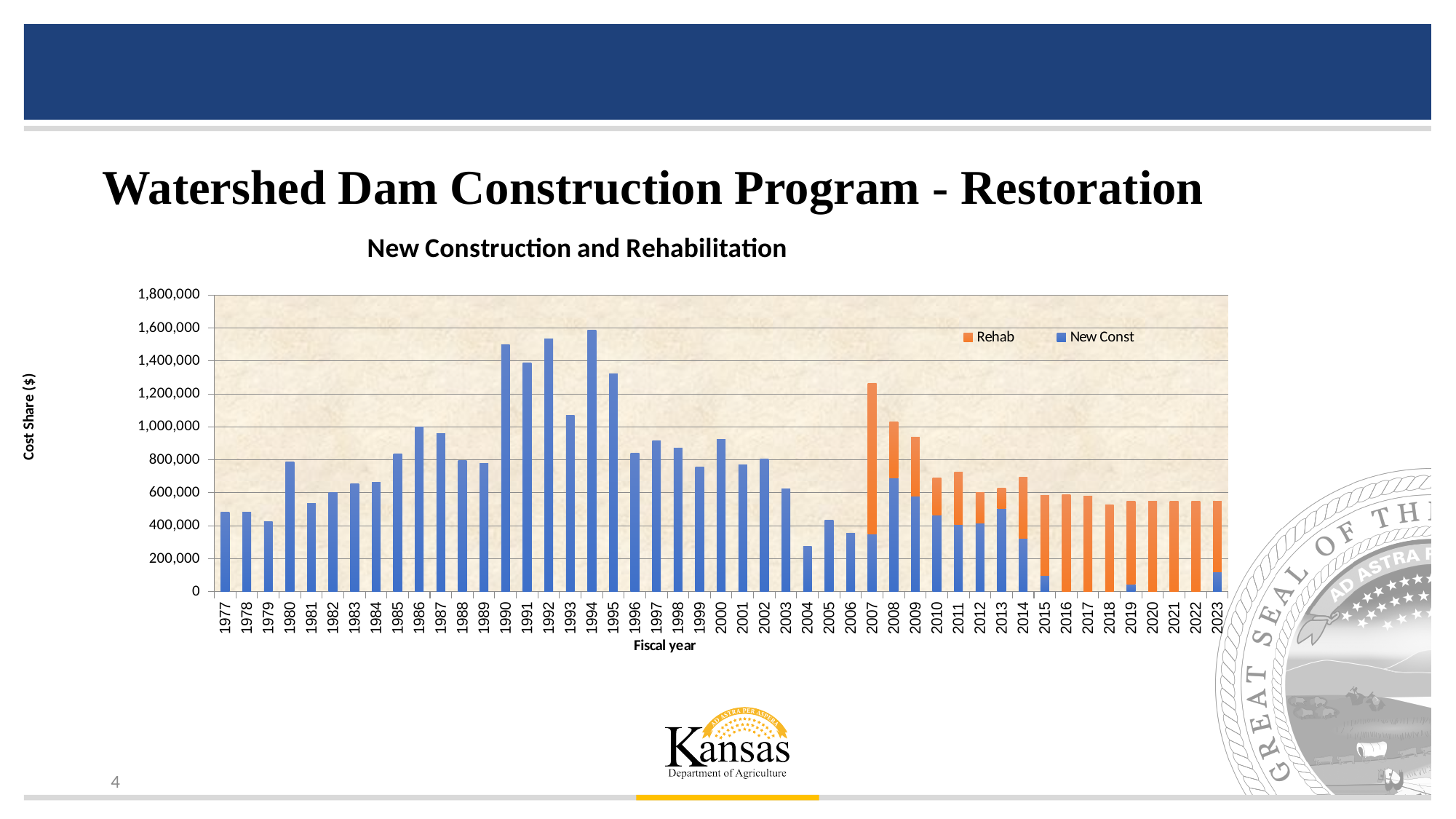
Is the total bar for 1994 greater or less than 1,400,000? greater Which colour represents the Rehab series in the chart? Orange Is the total bar for 2007 greater or less than 1,200,000? greater Which fiscal year has the shortest bar in the chart? 2004 How many fiscal years are shown on the x axis of the chart? 47 How many series does the legend list in the chart? 2 Which fiscal year has the larger bar, 1990 or 1980? 1990 Which fiscal year has the tallest bar in the chart? 1994 Do the bar totals generally rise or fall from 1994 to 2004? fall Is the bar for 2016 greater or less than 800,000? less What kind of chart is shown on the slide? Stacked bar chart